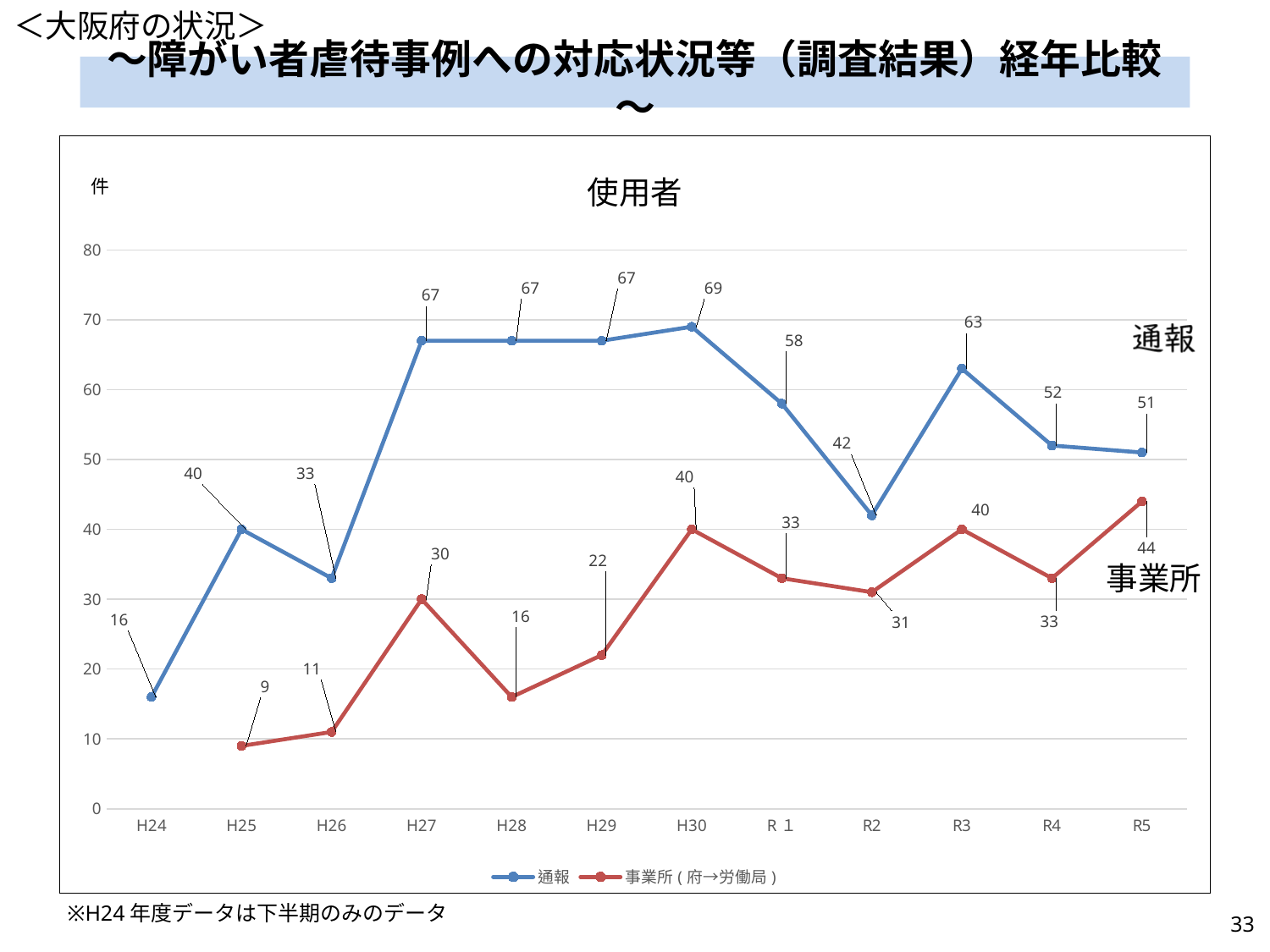
What type of chart is shown on the slide? line chart How many series does the legend list? 2 What is the title of the chart? 使用者 Does the 通報 series rise or fall from R3 to R5? fall What is the value of 事業所 for R5? 44 In which year is the 通報 series highest? H30 What is the value of 通報 for H24? 16 What is the difference between 通報 and 事業所 in R2? 11 How many categories are shown on the x axis? 12 In which year is the 事業所 series lowest? H25 Which is larger in R3, 通報 or 事業所? 通報 What is the value of 通報 for H30? 69